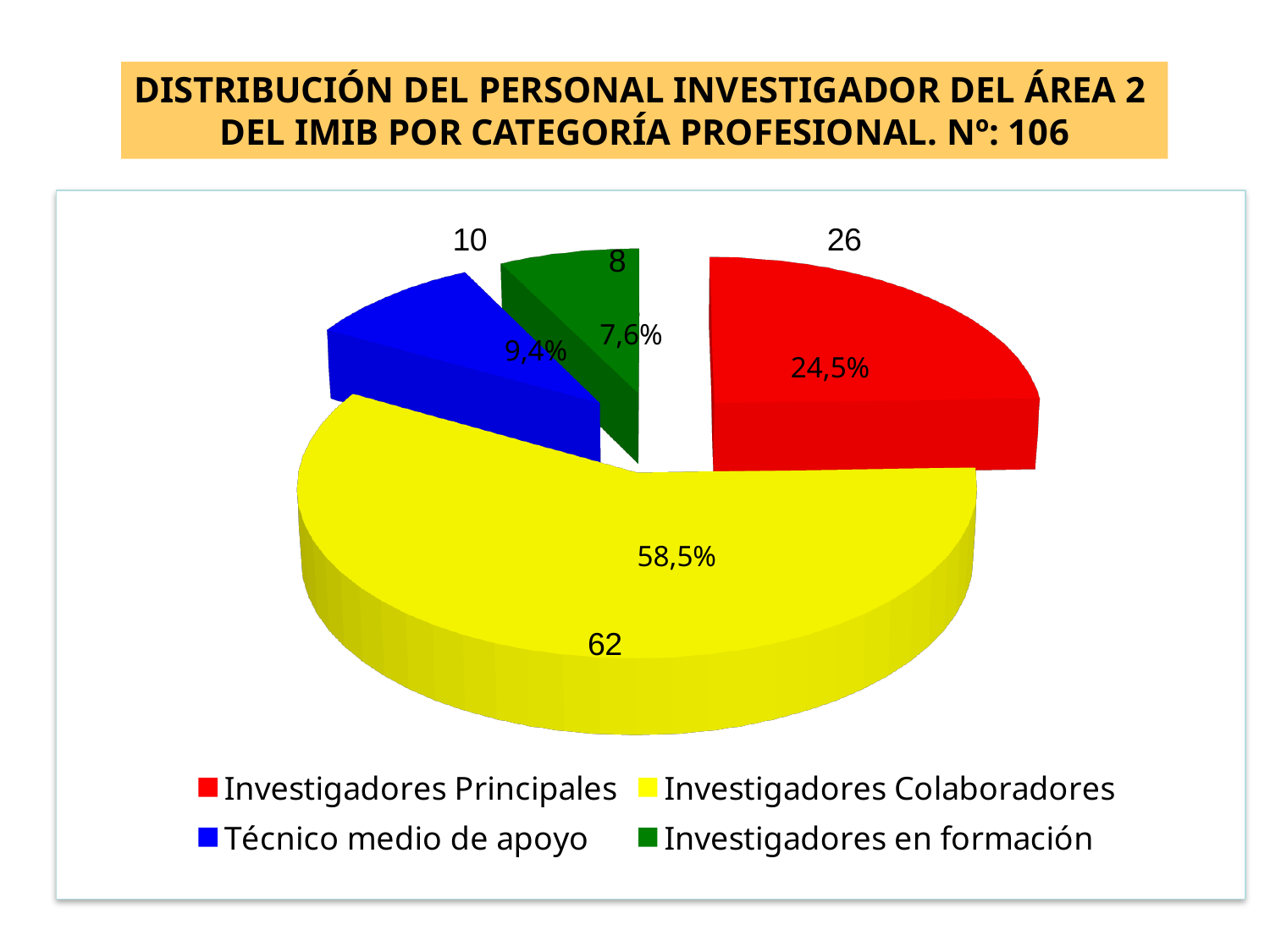
Which category has the smallest slice? Investigadores en formación What is the value for Técnico medio de apoyo? 10 What share of the pie does Investigadores Colaboradores represent? 58,5% How many categories does the pie chart show? 4 What kind of chart is shown on the slide? pie chart What is the value for Investigadores en formación? 8 Which colour represents Técnico medio de apoyo in the pie chart? blue What is the value for Investigadores Principales? 26 What is the value for Investigadores Colaboradores? 62 What share of the pie does Investigadores Principales represent? 24,5% Which category has the largest slice? Investigadores Colaboradores What is the difference between the values for Investigadores Colaboradores and Investigadores Principales? 36